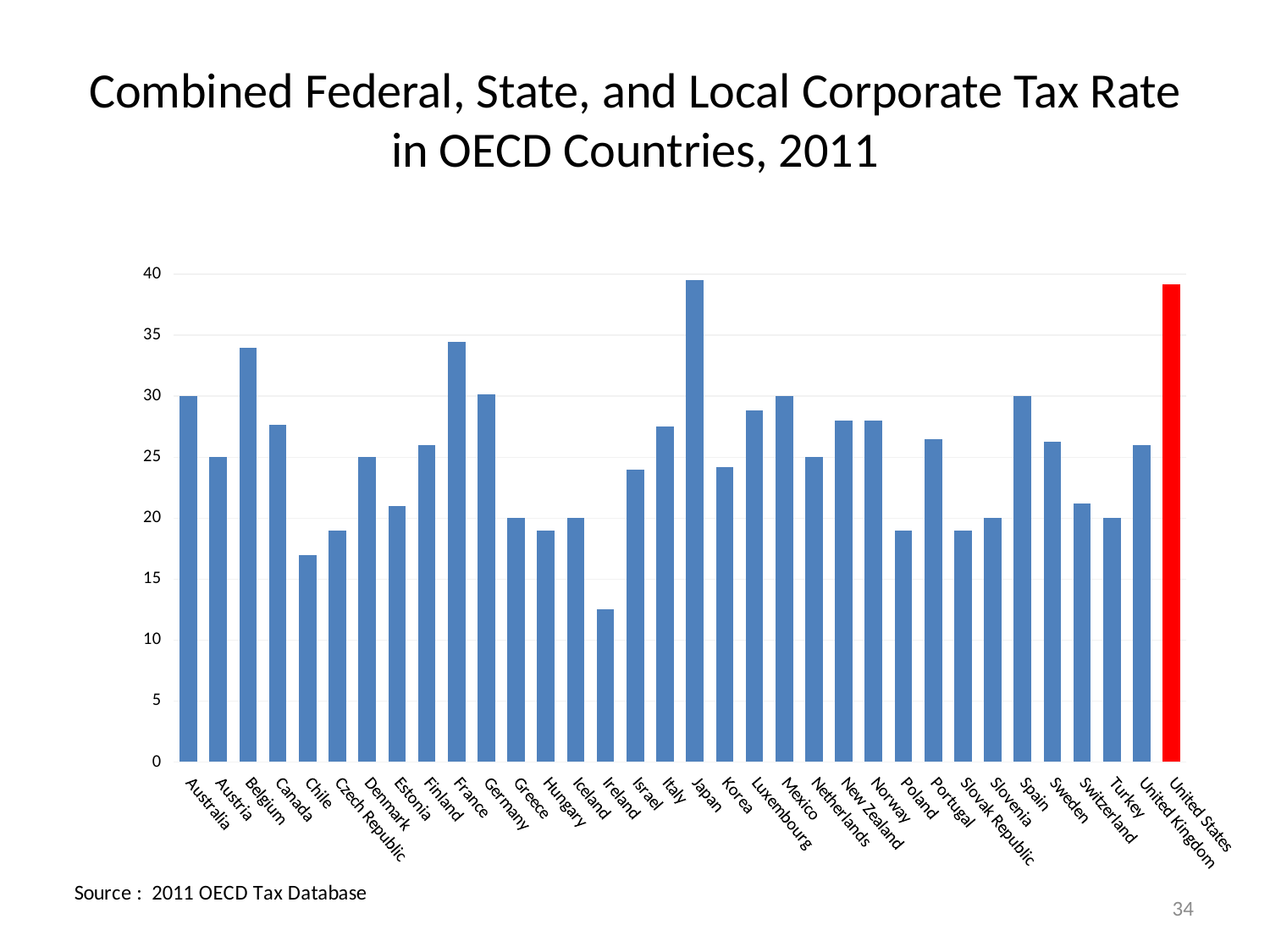
Is the value for Belgium greater or less than 30? greater What is the combined corporate tax rate for Greece? 20 Is the value for Japan greater or less than 35? greater Is the value for Ireland greater or less than 15? less How many countries are shown in the chart? 34 What is the combined corporate tax rate for Australia? 30 Which country has the lowest combined corporate tax rate in the chart? Ireland Which has the higher combined corporate tax rate, Ireland or Chile? Chile Which has the higher combined corporate tax rate, Belgium or Canada? Belgium What kind of chart is shown on the slide? bar chart Which country's bar is coloured red in the chart? United States